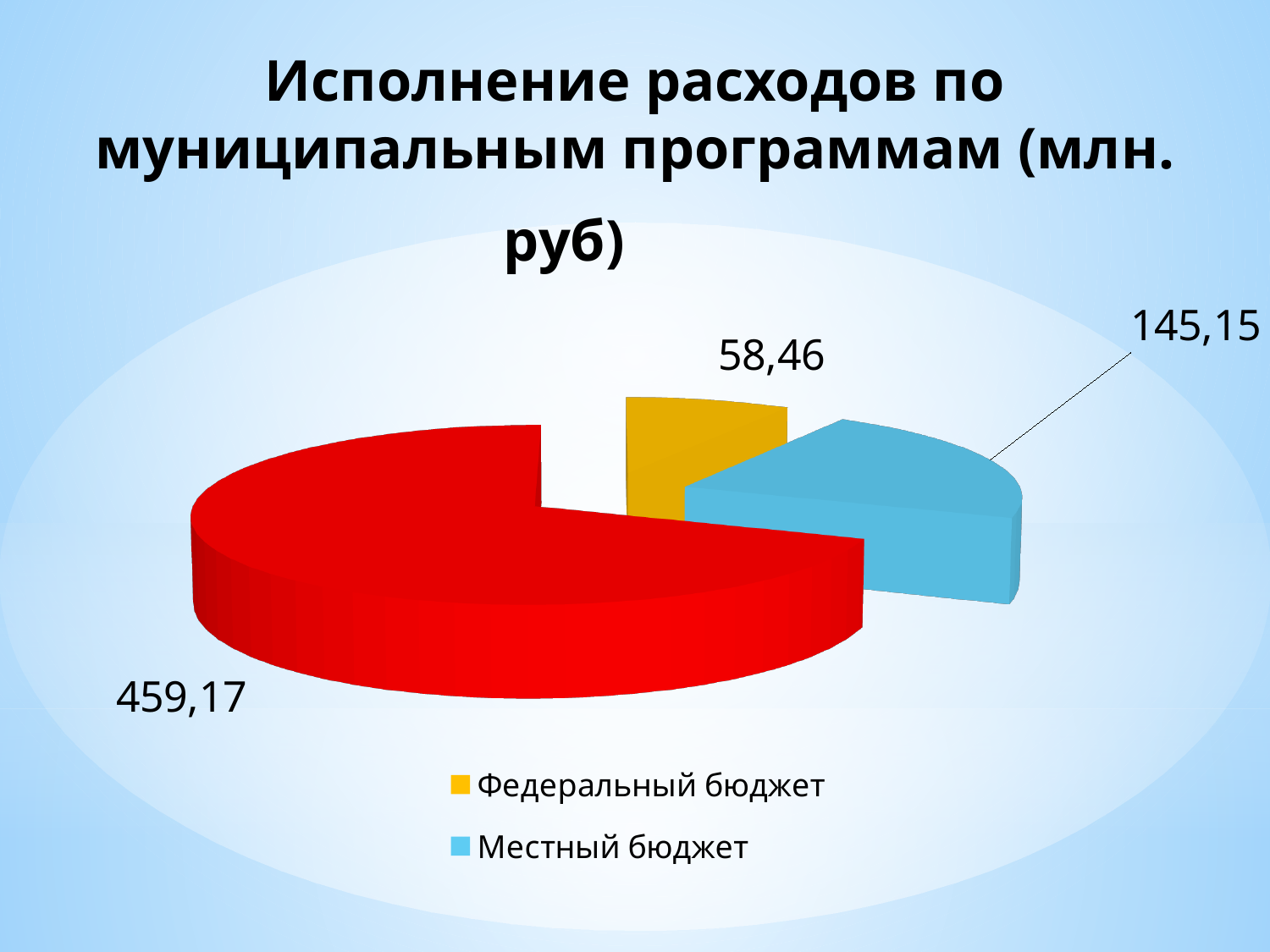
What is the difference between the values for Местный бюджет and Федеральный бюджет? 86,69 What is the value for Местный бюджет? 145,15 What kind of chart is shown on the slide? pie chart How many entries does the legend list? 2 What is the value shown for the red slice of the pie? 459,17 How many slices does the pie chart have? 3 Which is larger, the value for Местный бюджет or the value for Федеральный бюджет? Местный бюджет Which slice of the pie has the largest value? the red slice (459,17) What is the total of all three slice values? 662,78 What colour is the slice for Местный бюджет? blue What is the value for Федеральный бюджет? 58,46 Which of the two legend categories has the smaller value? Федеральный бюджет